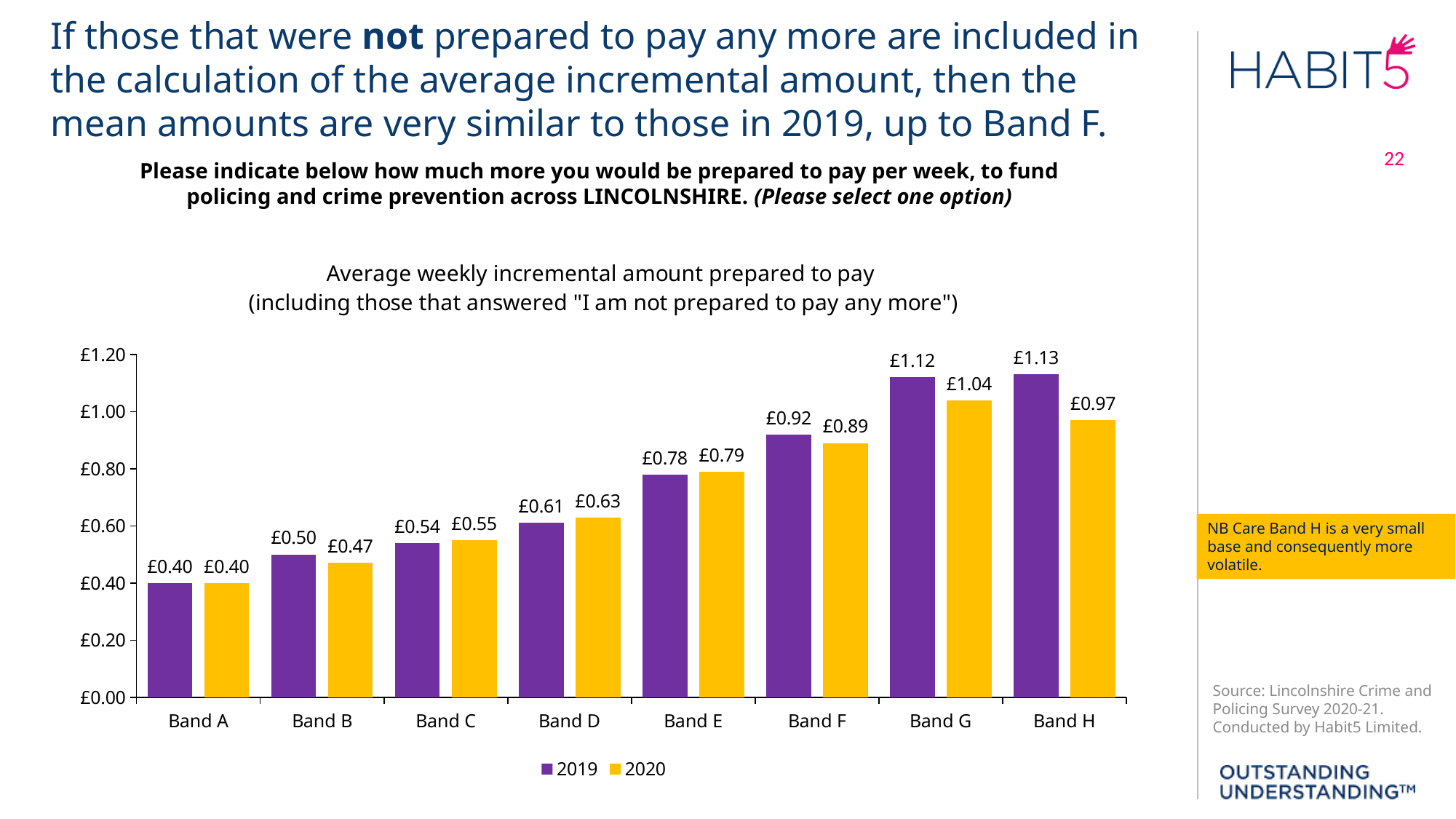
What is the 2020 value for Band B? £0.47 What is the difference between the 2019 and 2020 values for Band H? £0.16 Do the 2019 values rise or fall from Band A to Band H? rise Which band has the lowest 2020 value? Band A Which is larger for Band G, the 2019 value or the 2020 value? 2019 Which band has the highest 2019 value? Band H Is the 2020 value for Band F greater or less than £1.00? less What is the 2020 value for Band G? £1.04 How many series does the legend list? 2 What is the 2019 value for Band D? £0.61 What kind of chart is shown? bar chart How many bands are shown on the x axis? 8